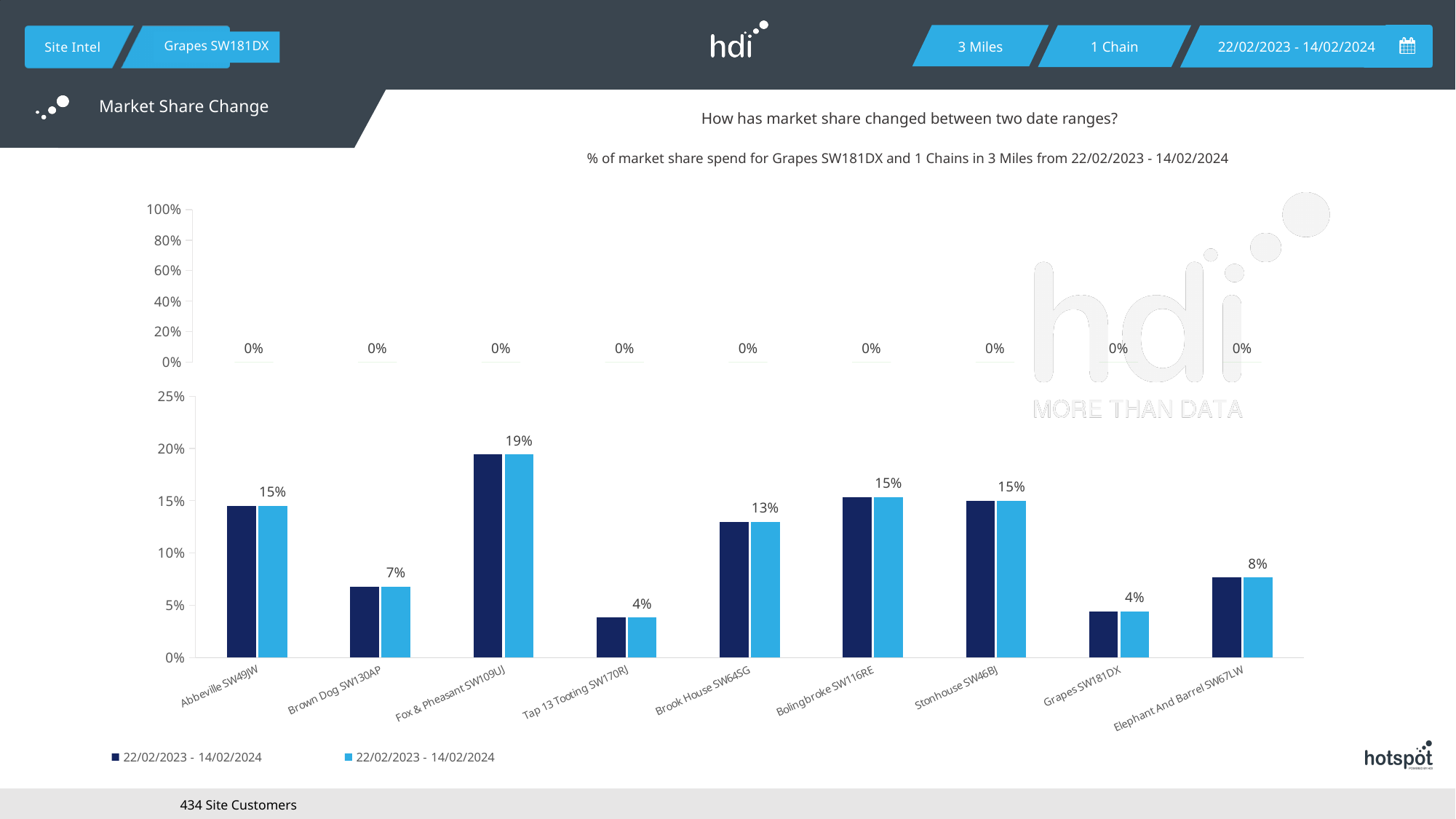
On the bottom chart, what is the labelled market share value for Grapes SW181DX? 4% On the bottom chart, which has the larger market share, Brook House SW64SG or Elephant And Barrel SW67LW? Brook House SW64SG On the bottom chart, what is the difference between the market share of Fox & Pheasant SW109UJ and Brown Dog SW130AP? 12 percentage points What is the subtitle text shown above the charts describing the data? % of market share spend for Grapes SW181DX and 1 Chains in 3 Miles from 22/02/2023 - 14/02/2024 On the bottom chart, what is the labelled market share value for Fox & Pheasant SW109UJ? 19% On the bottom chart, what is the labelled market share value for Brown Dog SW130AP? 7% How many venues are shown on the x axis of the bottom chart? 9 What kind of chart is the bottom chart? Bar chart On the bottom chart, is the value for Bolingbroke SW116RE greater or less than 10%? greater How many series does the legend of the bottom chart list? 2 On the bottom chart, which venue has the highest market share? Fox & Pheasant SW109UJ On the top chart, what is the labelled value for Stonhouse SW46BJ? 0%